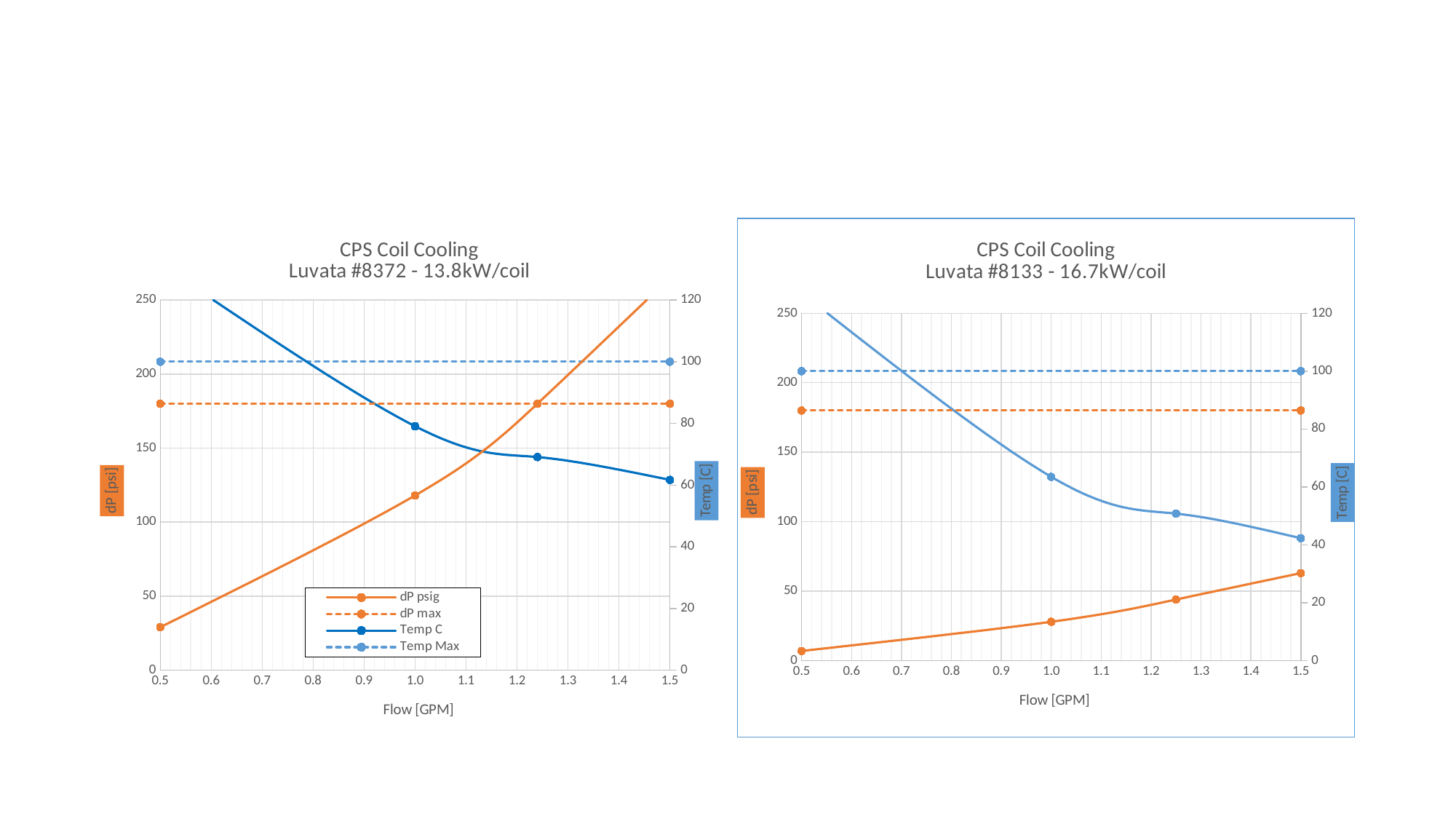
In the right chart (Luvata #8133), is the blue temperature value higher at 1.0 GPM or at 1.5 GPM? 1.0 GPM In the left chart (Luvata #8372), is the dP psig value at 1.0 GPM greater or less than 100? greater In the right chart (Luvata #8133), is the blue temperature value at 1.0 GPM greater or less than 80? less How many series does the legend of the left chart (Luvata #8372) list? 4 In the left chart (Luvata #8372), is the dP psig value larger at 1.0 GPM or at 1.5 GPM? 1.5 GPM In the left chart (Luvata #8372), does the dP psig series rise or fall as flow increases? rise In the left chart (Luvata #8372), does the Temp C series rise or fall as flow increases? fall What kind of chart is the left chart, 'CPS Coil Cooling Luvata #8372 - 13.8kW/coil'? line chart In the left chart (Luvata #8372), is the Temp C value at 1.5 GPM greater or less than 80? less What is the x-axis label of the right chart (Luvata #8133)? Flow [GPM] In the right chart (Luvata #8133), does the orange dP series rise or fall as flow increases? rise